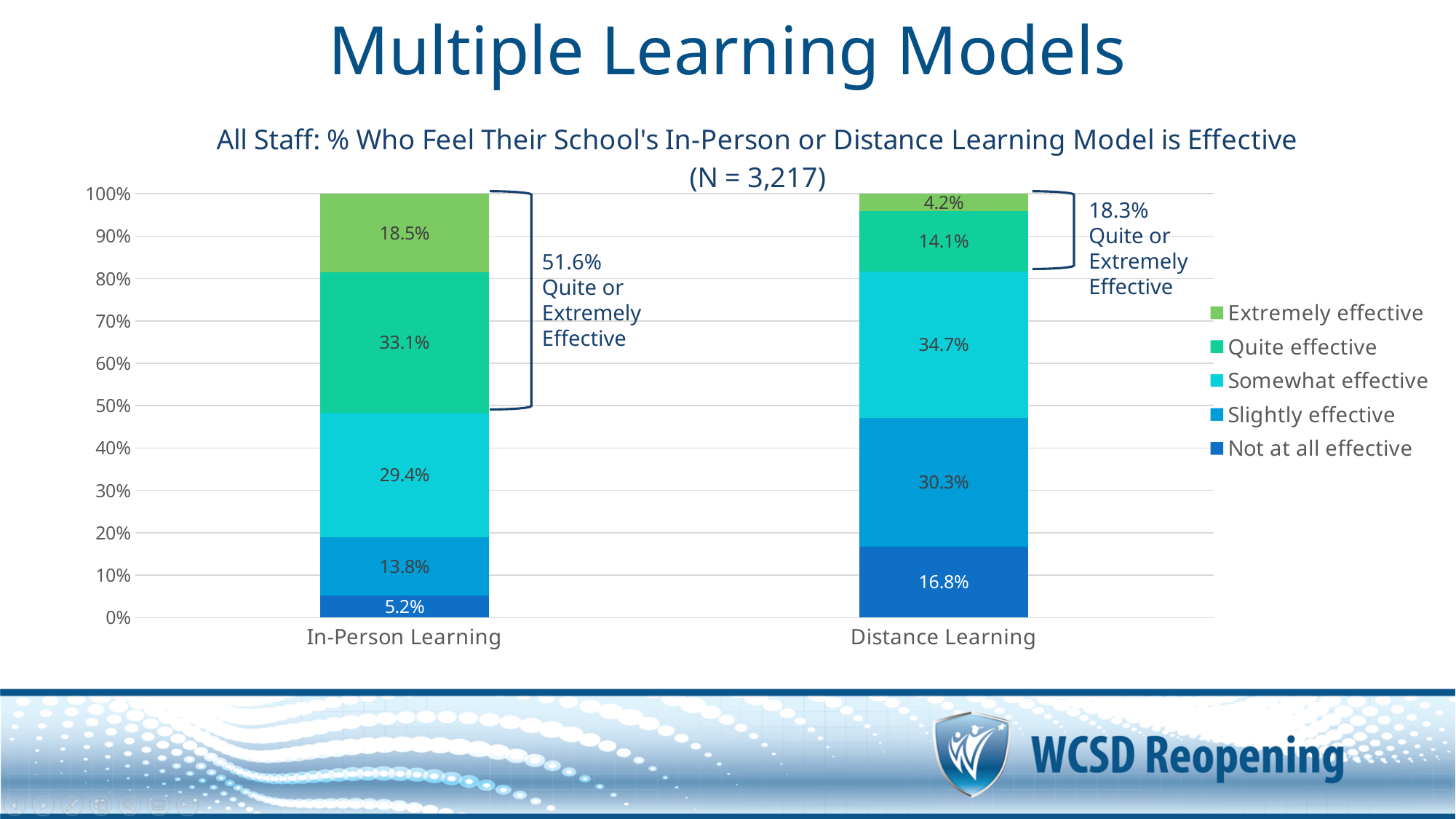
What is the sample size (N) stated in the chart title? 3,217 How many learning models are shown on the x axis? 2 What is the combined Quite or Extremely Effective percentage for Distance Learning? 18.3% What percentage of staff rated Distance Learning as Somewhat effective? 34.7% What percentage of staff rated Distance Learning as Not at all effective? 16.8% What percentage of staff rated In-Person Learning as Extremely effective? 18.5% What percentage of staff rated In-Person Learning as Slightly effective? 13.8% Which learning model has the higher Quite effective percentage? In-Person Learning What is the combined Quite or Extremely Effective percentage for In-Person Learning? 51.6% What is the difference between the Extremely effective percentages for In-Person Learning and Distance Learning? 14.3% How many series does the legend list? 5 What kind of chart is shown on the slide? Stacked bar chart